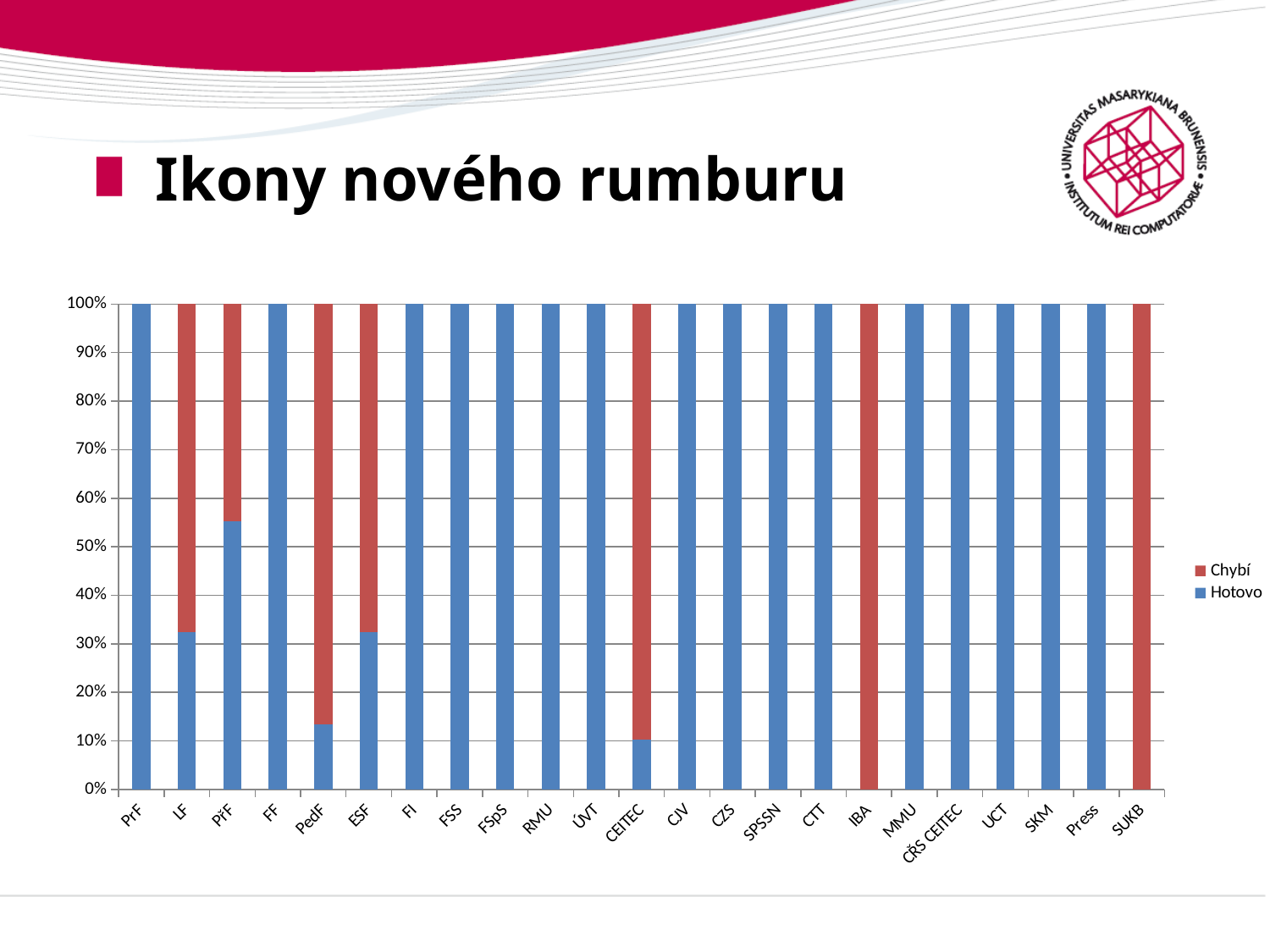
Which has the larger Hotovo value, PřF or LF? PřF Is the Hotovo value for LF greater or less than 40%? less What is the Hotovo value for PrF? 100% How many series does the legend list? 2 What are the two series named in the legend? Chybí and Hotovo Is the Hotovo value for PedF greater or less than 20%? less What is the Chybí value for SUKB? 100% What kind of chart is shown on the slide? stacked bar chart What is the Chybí value for IBA? 100% How many categories are shown on the x axis? 23 Is the Hotovo value for PřF greater or less than 50%? greater